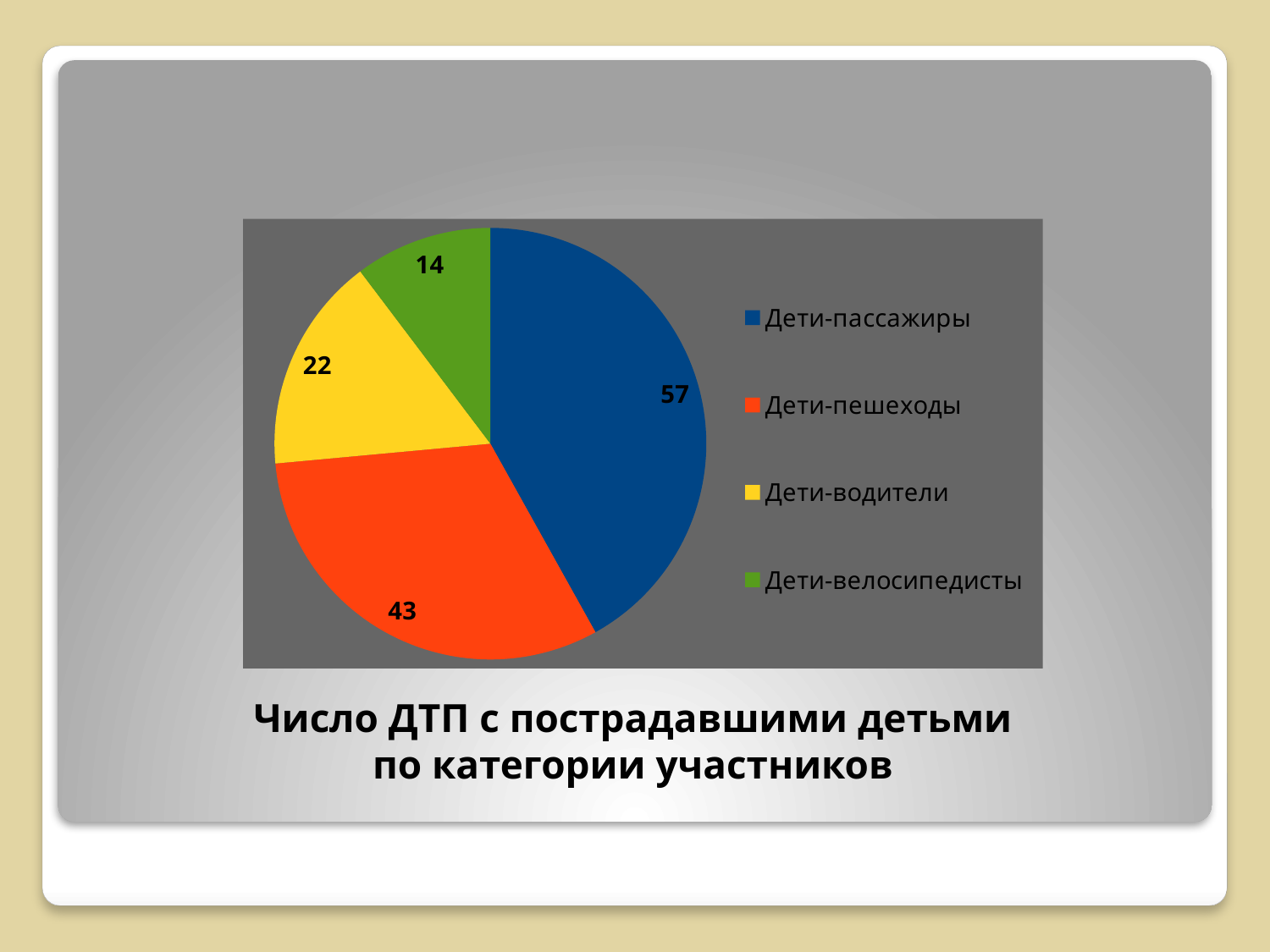
What is the value for Дети-водители? 22 What is the value for Дети-пассажиры? 57 What is the difference between the values for Дети-пассажиры and Дети-пешеходы? 14 How many categories does the pie chart show? 4 What type of chart is shown on the slide? Pie chart Which category has the smallest slice of the pie? Дети-велосипедисты Which is larger, the value for Дети-водители or the value for Дети-велосипедисты? Дети-водители Which category has the largest slice of the pie? Дети-пассажиры What is the total of all slices in the pie chart? 136 What is the value for Дети-пешеходы? 43 What is the title of the chart? Число ДТП с пострадавшими детьми по категории участников What is the value for Дети-велосипедисты? 14